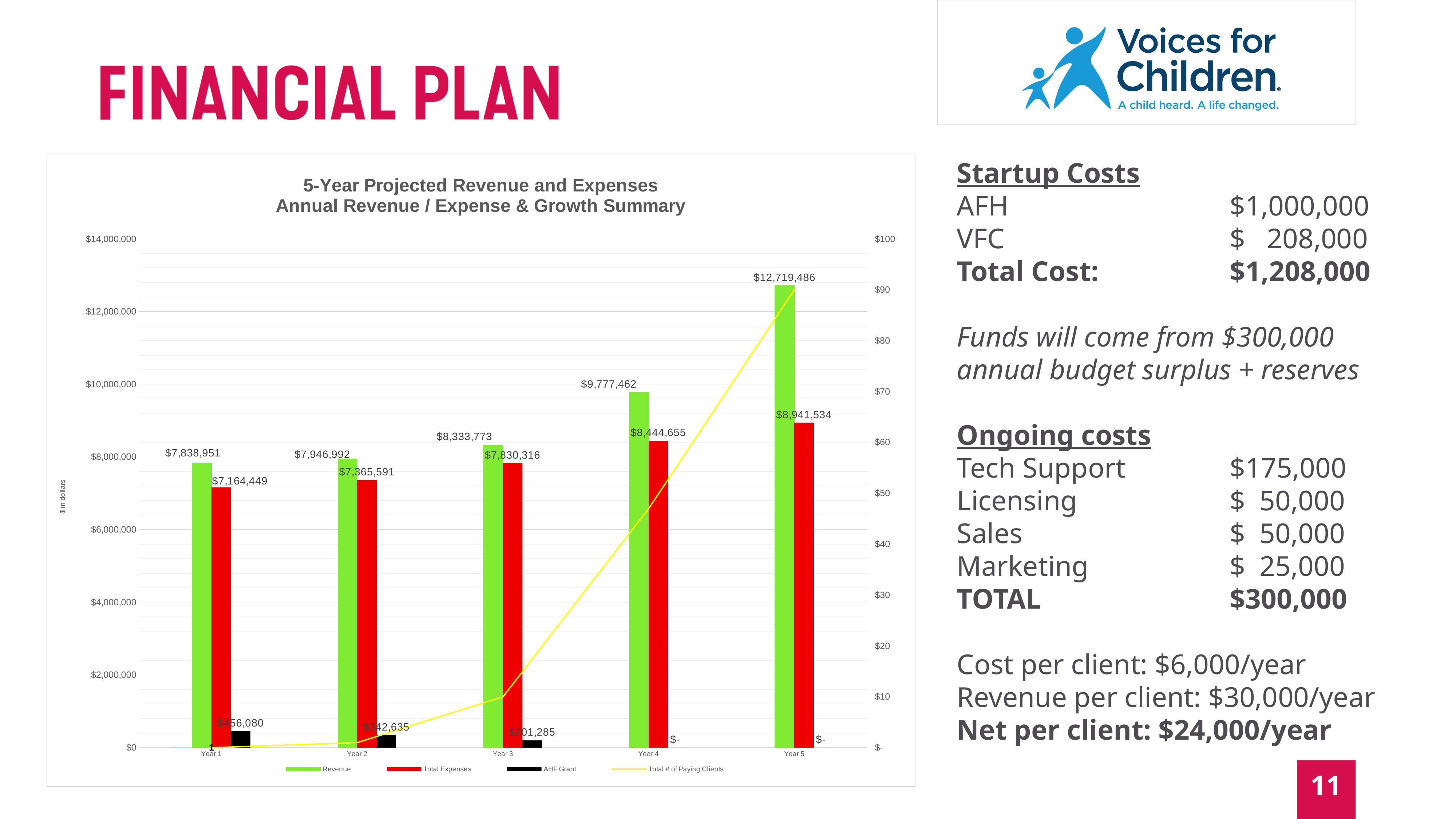
What is the Revenue value for Year 5? $12,719,486 Is the Total # of Paying Clients in Year 5 greater or less than 80? greater How many series does the legend list? 4 How many years are shown on the x axis? 5 Which year has the highest Revenue? Year 5 Which year has the lowest Total Expenses? Year 1 Which series is plotted as a yellow line? Total # of Paying Clients What is the difference between Revenue and Total Expenses in Year 5? $3,777,952 What is the Total Expenses value for Year 3? $7,830,316 Which is larger in Year 4: Revenue or Total Expenses? Revenue What is the AHF Grant value for Year 1? $456,080 Does Revenue rise or fall from Year 1 to Year 5? rise